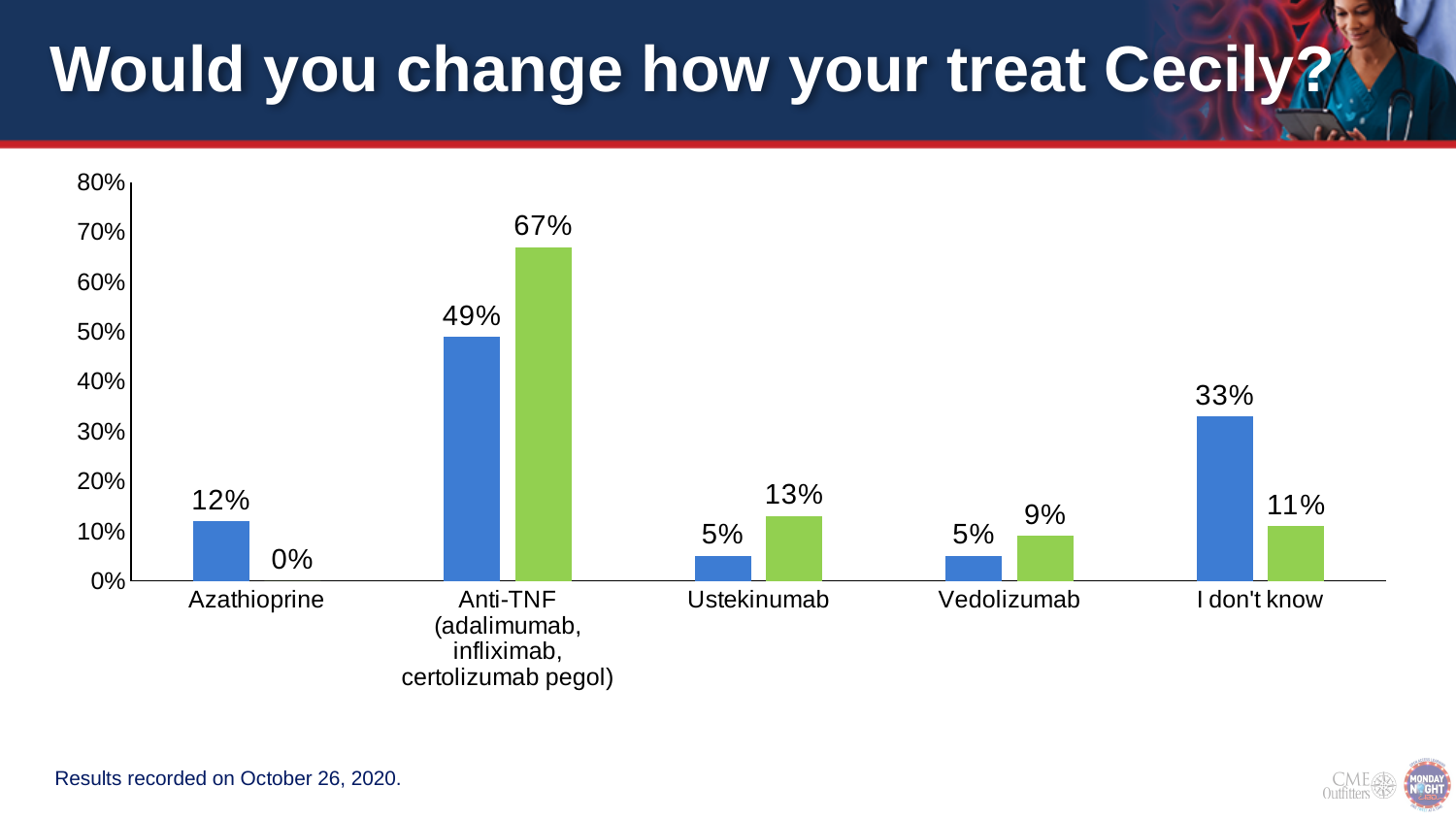
What is the difference between the blue and green bars for I don't know? 22% What is the value of the blue bar for I don't know? 33% What is the value of the blue bar for Anti-TNF (adalimumab, infliximab, certolizumab pegol)? 49% What kind of chart is shown on the slide? bar chart Which category has the lowest green bar? Azathioprine How many categories are shown on the x axis? 5 Which category has the highest green bar? Anti-TNF (adalimumab, infliximab, certolizumab pegol) What is the difference between the green and blue bars for Anti-TNF (adalimumab, infliximab, certolizumab pegol)? 18% Is the blue bar for I don't know greater or less than 30%? greater Which is larger for Ustekinumab, the blue bar or the green bar? the green bar What is the value of the green bar for Azathioprine? 0% What is the value of the green bar for Anti-TNF (adalimumab, infliximab, certolizumab pegol)? 67%